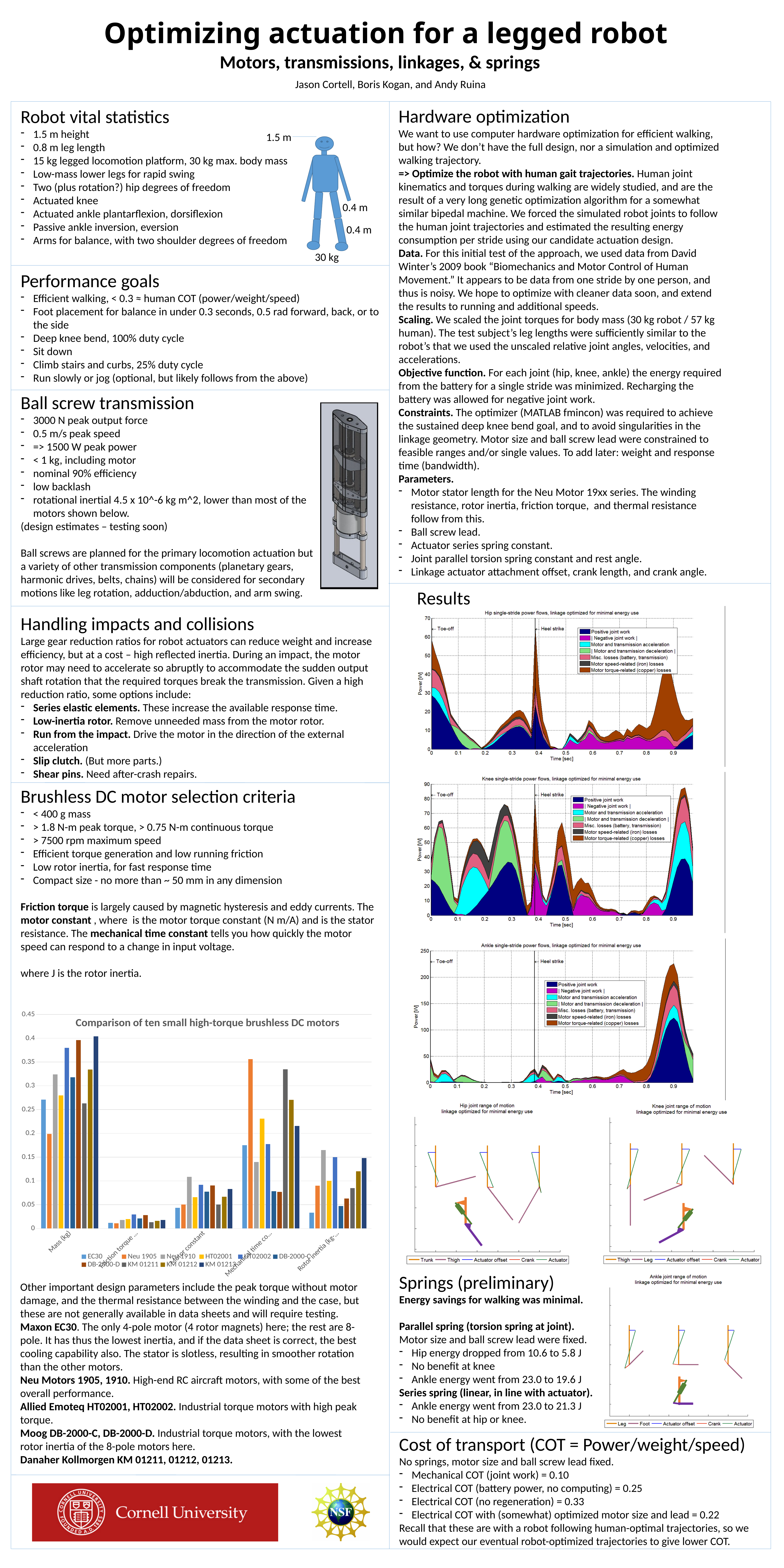
What is the maximum value shown on the Power [W] axis of the 'Ankle single-stride power flows' chart? 250 In the chart 'Comparison of ten small high-torque brushless DC motors', is the Mass (kg) value for Neu 1905 greater or less than 0.25? less In the chart 'Comparison of ten small high-torque brushless DC motors', which is larger in the Mass (kg) category: EC30 or Neu 1905? EC30 In the chart 'Comparison of ten small high-torque brushless DC motors', which motor has the highest value in the Mechanical time constant category? Neu 1905 In the chart 'Comparison of ten small high-torque brushless DC motors', is the Mass (kg) value for KM 01213 greater or less than 0.35? greater In the 'Hip single-stride power flows' chart, how many series does the legend list? 7 In the chart 'Comparison of ten small high-torque brushless DC motors', how many motors (series) does the legend list? 10 What kind of chart is 'Comparison of ten small high-torque brushless DC motors'? bar chart In the chart 'Comparison of ten small high-torque brushless DC motors', is the Mechanical time constant value for Neu 1905 greater or less than 0.3? greater In the chart 'Comparison of ten small high-torque brushless DC motors', how many parameter categories are shown on the x axis? 5 In the chart 'Comparison of ten small high-torque brushless DC motors', which motor has the lowest value in the Mass (kg) category? Neu 1905